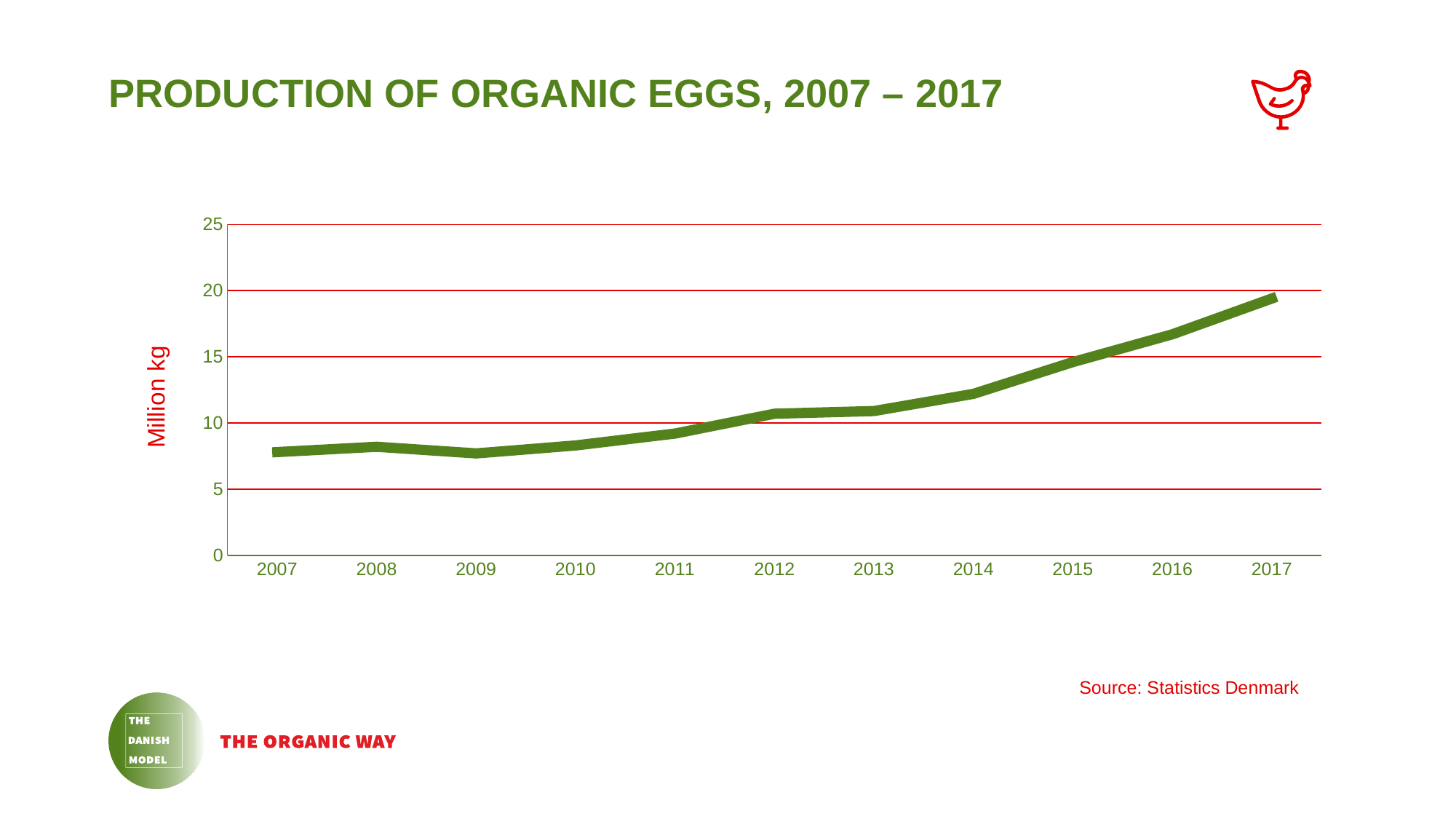
Is the value for 2017 greater or less than 15? greater Which year has the lowest production of organic eggs? 2009 Which year has the larger value, 2012 or 2016? 2016 Is the value for 2014 greater or less than 10? greater What is the title of the chart? PRODUCTION OF ORGANIC EGGS, 2007 – 2017 What kind of chart is shown on the slide? line chart What is the label on the vertical axis? Million kg Is the value for 2016 greater or less than 20? less How many years are shown on the x axis? 11 Which year has the highest production of organic eggs? 2017 Does the production of organic eggs generally rise or fall from 2009 to 2017? rise